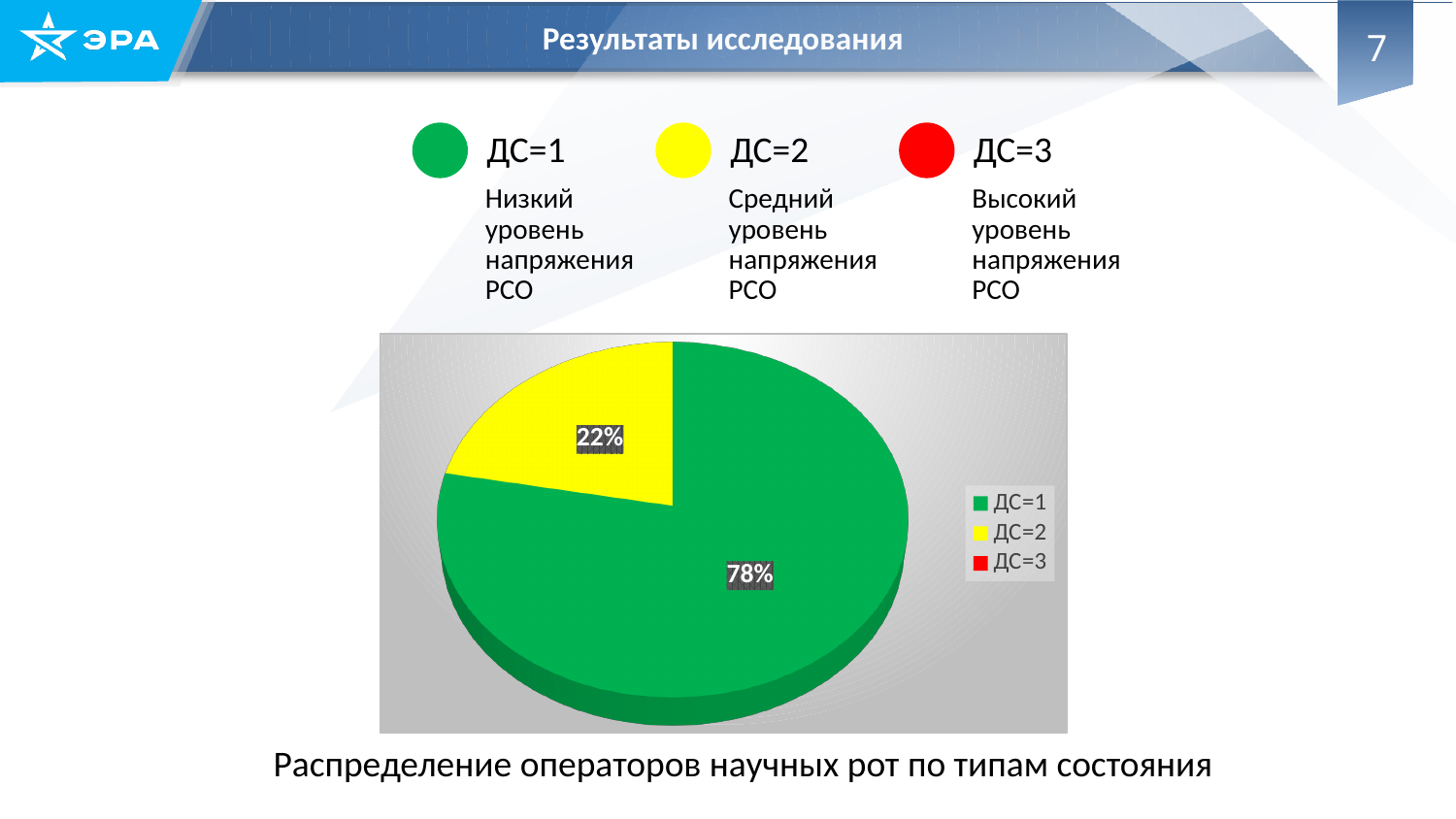
How many slices are visibly plotted in the pie? 2 Which of the visible slices is the smallest? ДС=2 What colour is the ДС=2 slice? Yellow Which category has the largest slice of the pie? ДС=1 What share of the pie does ДС=1 account for? 78% What is the difference in percentage points between the ДС=1 slice and the ДС=2 slice? 56 How many entries does the chart legend list? 3 What type of chart is shown on the slide? Pie chart Which slice is larger, ДС=1 or ДС=2? ДС=1 Is the share for ДС=1 greater or less than 50%? greater What colour is the ДС=1 slice? Green What share of the pie does ДС=2 account for? 22%